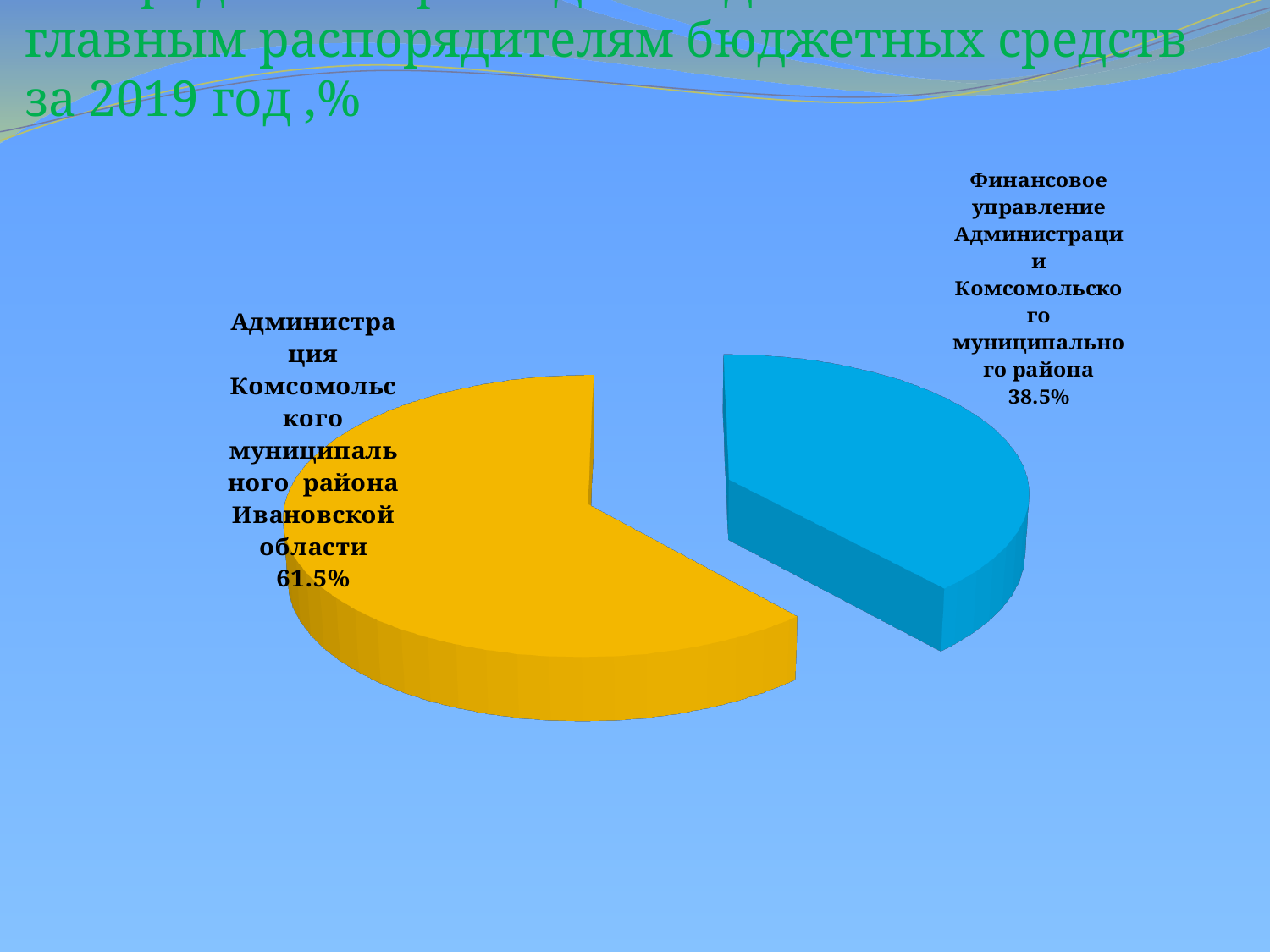
What kind of chart is shown on the slide? Pie chart Which slice of the pie chart is the smallest? Финансовое управление Администрации Комсомольского муниципального района What colour is the slice for Финансовое управление Администрации Комсомольского муниципального района? Blue What colour is the slice for Администрация Комсомольского муниципального района Ивановской области? Yellow What share of the pie is labelled for Администрация Комсомольского муниципального района Ивановской области? 61.5% Is the share for Финансовое управление Администрации Комсомольского муниципального района greater or less than 50%? less Which slice of the pie chart is the largest? Администрация Комсомольского муниципального района Ивановской области How many slices does the pie chart have? 2 What is the total of the two slice percentages shown on the pie chart? 100% Which is larger: the share for Администрация Комсомольского муниципального района Ивановской области or the share for Финансовое управление? Администрация Комсомольского муниципального района Ивановской области What is the difference in percentage points between the Администрация slice and the Финансовое управление slice? 23 percentage points What share of the pie is labelled for Финансовое управление Администрации Комсомольского муниципального района? 38.5%